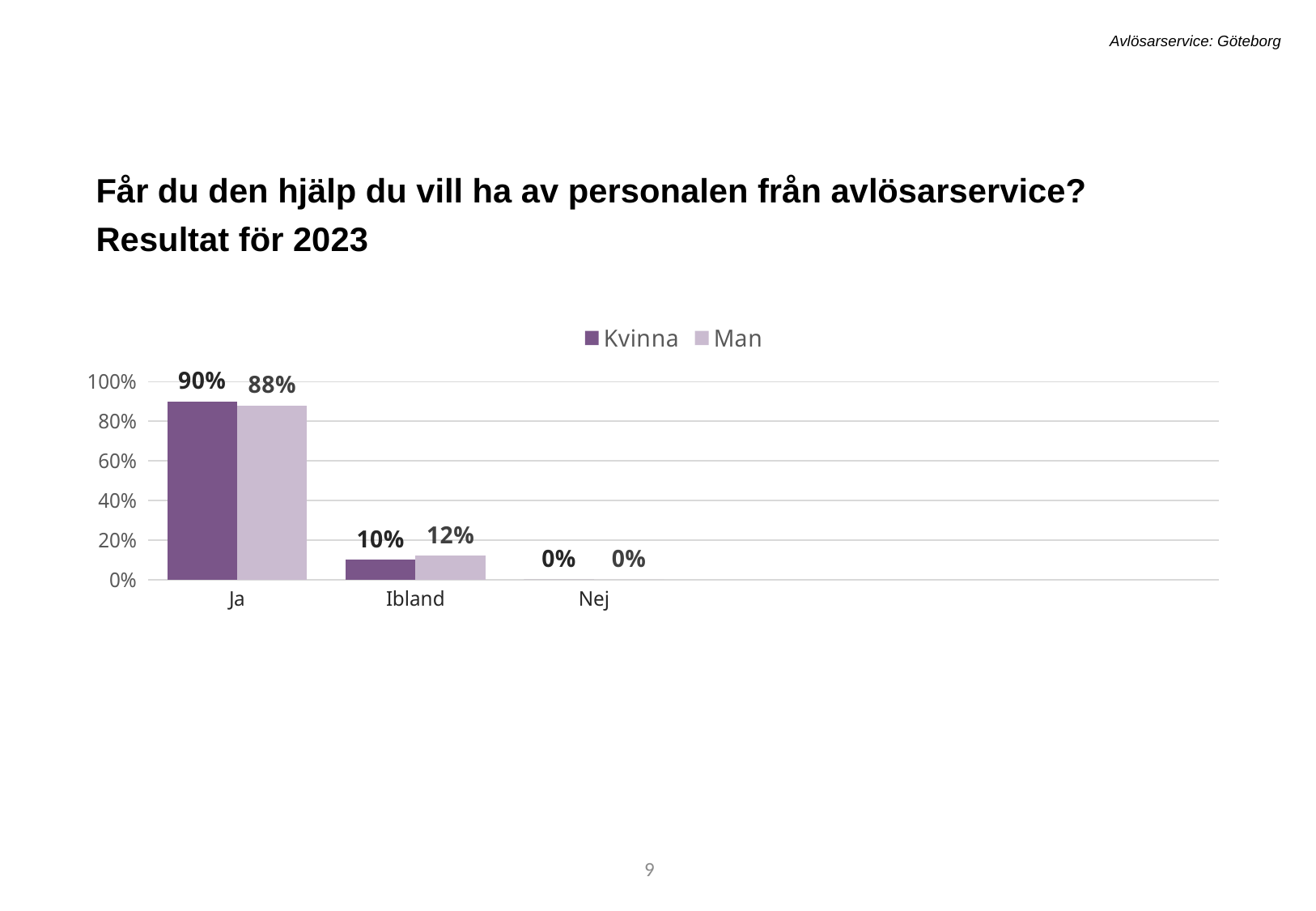
What is the value for Man in the Ibland category? 12% What is the difference between the Kvinna and Man values in the Ja category? 2% Which category has the lowest value for Man? Nej What kind of chart is shown on the slide? Bar chart What is the value for Kvinna in the Ja category? 90% What is the value for Man in the Ja category? 88% In the Ibland category, which series has the larger value, Kvinna or Man? Man Which category has the highest value for Kvinna? Ja How many series does the legend list? 2 How many categories are shown on the x axis? 3 What is the value for Man in the Nej category? 0% What is the value for Kvinna in the Ibland category? 10%